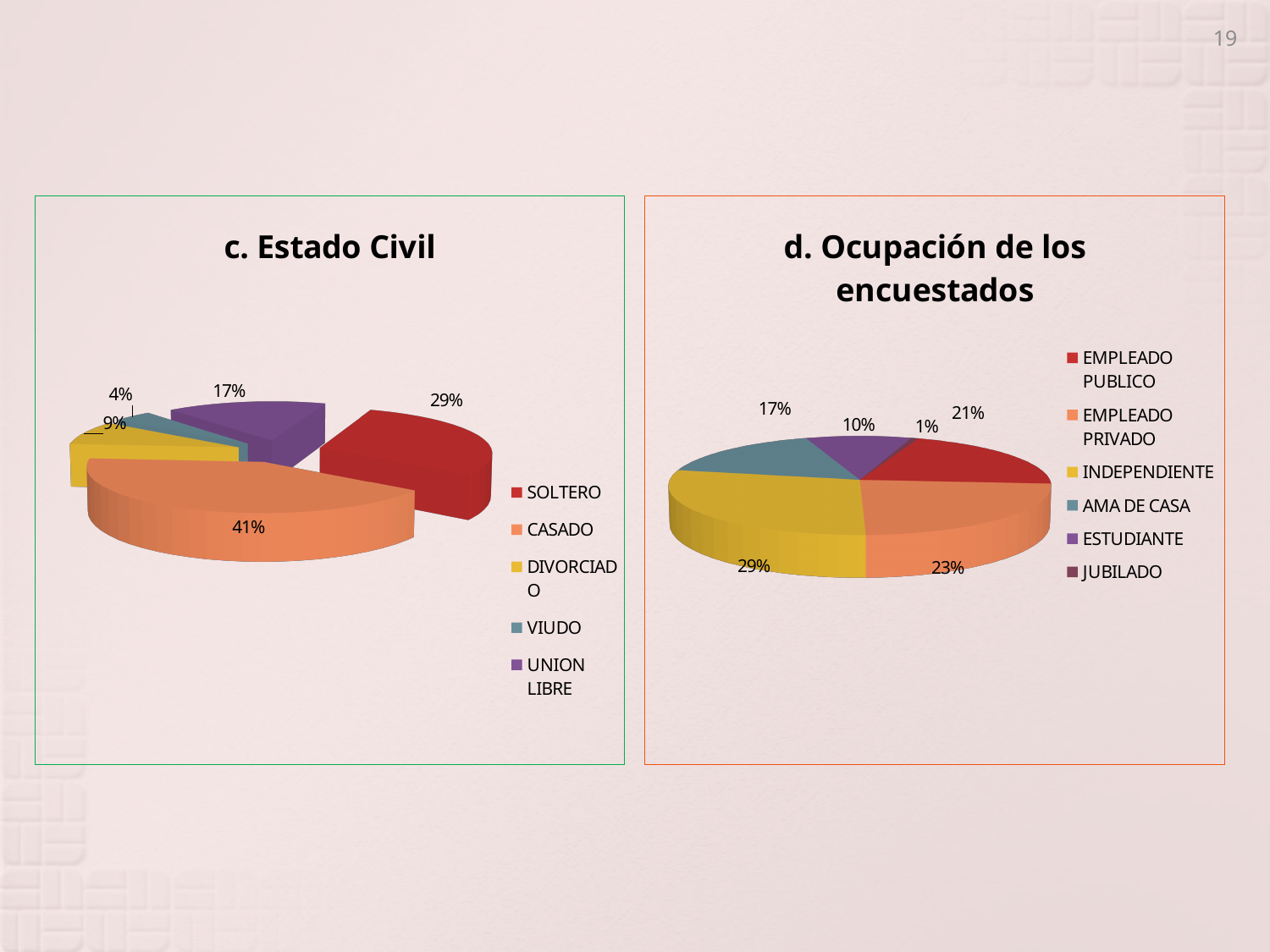
In the 'd. Ocupación de los encuestados' chart, what percentage is shown for JUBILADO? 1% In the 'd. Ocupación de los encuestados' chart, what is the difference between the AMA DE CASA and ESTUDIANTE percentages? 7% In the 'c. Estado Civil' chart, what percentage is shown for CASADO? 41% In the 'c. Estado Civil' chart, what is the difference between the SOLTERO and UNION LIBRE percentages? 12% In the 'd. Ocupación de los encuestados' chart, what percentage is shown for INDEPENDIENTE? 29% In the 'c. Estado Civil' chart, how many categories does the legend list? 5 In the 'd. Ocupación de los encuestados' chart, which is larger, EMPLEADO PUBLICO or EMPLEADO PRIVADO? EMPLEADO PRIVADO In the 'c. Estado Civil' chart, which category has the smallest share? VIUDO In the 'c. Estado Civil' chart, what percentage is shown for VIUDO? 4% In the 'c. Estado Civil' chart, which category has the largest share? CASADO In the 'd. Ocupación de los encuestados' chart, how many categories does the legend list? 6 What type of chart is 'd. Ocupación de los encuestados'? Pie chart